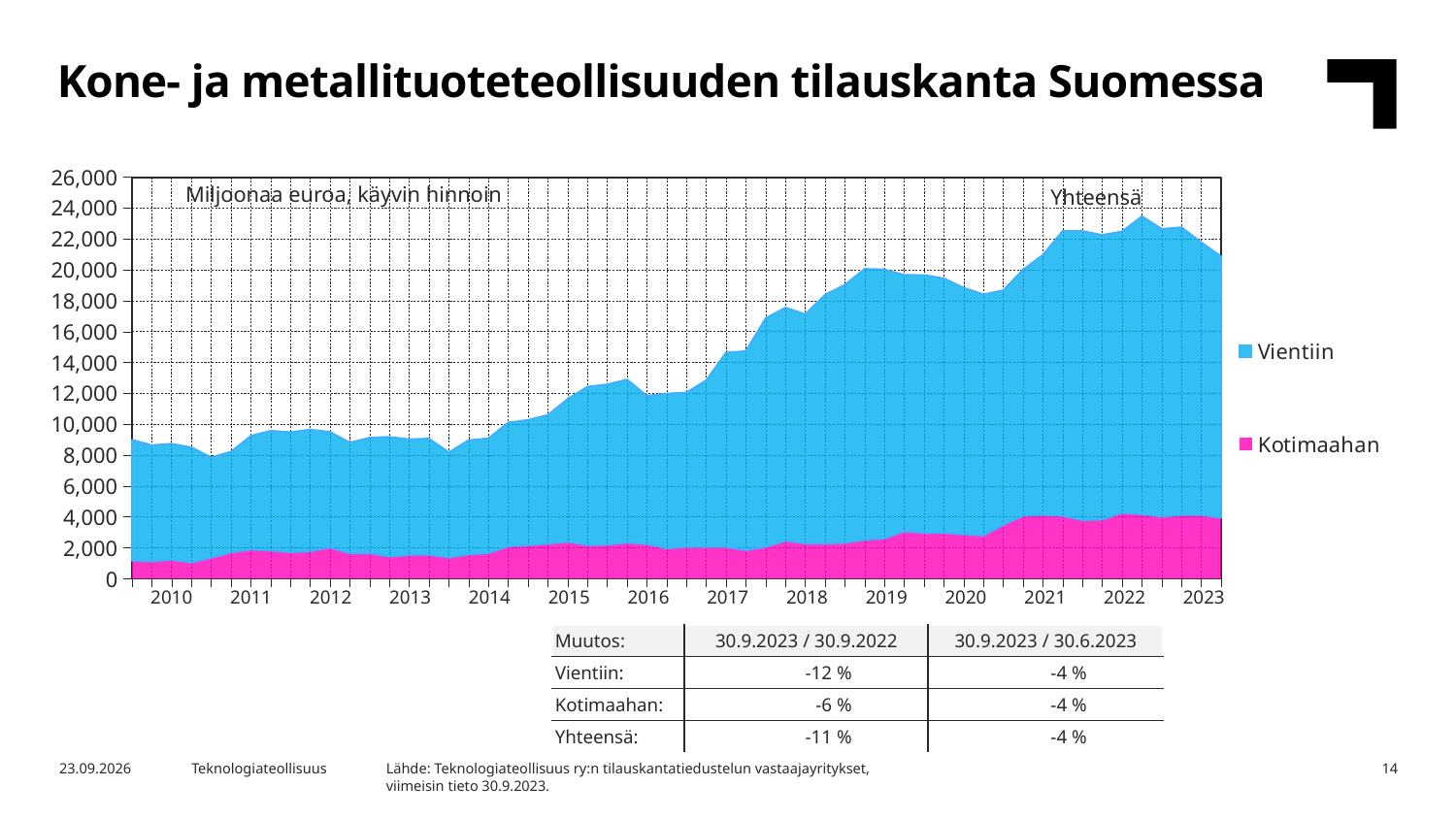
What kind of chart is shown on the slide? Stacked area chart How many years are labelled on the x axis of the chart? 14 Is the total order backlog at its 2022 peak greater or less than 22,000? greater Does the total order backlog generally rise or fall from 2016 to 2019? rise Is the Kotimaahan value in 2010 greater or less than 2,000? less How many series does the chart legend list? 2 What unit label is printed inside the chart area? Miljoonaa euroa, käyvin hinnoin Is the total order backlog at the end of 2023 greater or less than 18,000? greater In which year does the total (Yhteensä) order backlog reach its highest point? 2022 Which series is larger throughout the chart, Vientiin or Kotimaahan? Vientiin What are the two series named in the chart legend? Vientiin and Kotimaahan